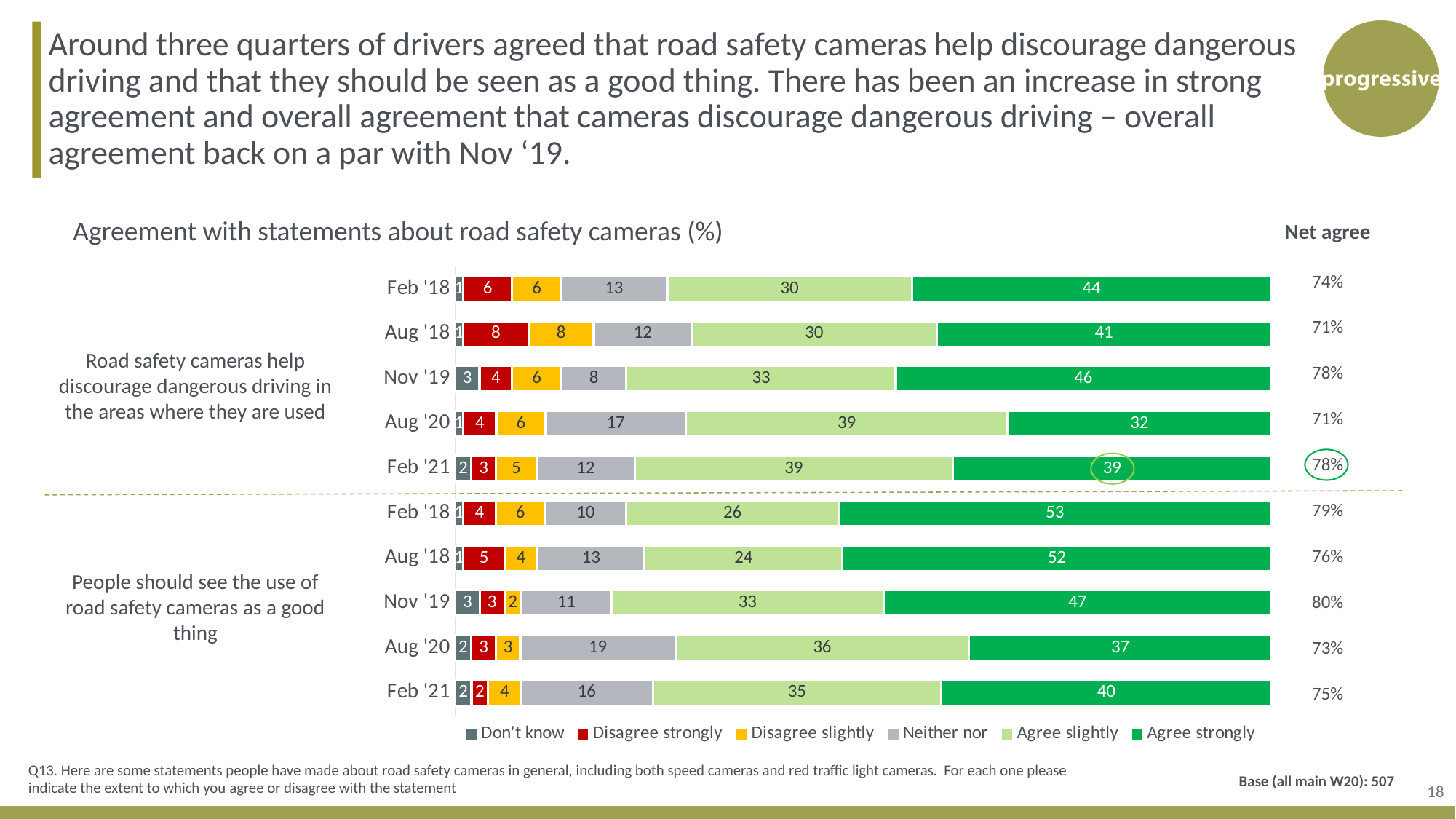
How many waves (bars) are shown for each statement in the chart? 5 For the statement 'People should see the use of road safety cameras as a good thing', is the 'Agree strongly' value larger in Nov '19 or Feb '21? Nov '19 What is the 'Neither nor' value for Aug '20 for the statement 'People should see the use of road safety cameras as a good thing'? 19 What is the Net agree figure for Nov '19 for the statement 'People should see the use of road safety cameras as a good thing'? 80% What is the combined 'Agree slightly' plus 'Agree strongly' total for Feb '21 for the statement 'Road safety cameras help discourage dangerous driving in the areas where they are used'? 78 Which wave has the lowest 'Agree strongly' value for the statement 'Road safety cameras help discourage dangerous driving in the areas where they are used'? Aug '20 What type of chart is shown on the slide? Stacked bar chart What is the title of the chart? Agreement with statements about road safety cameras (%) How many series does the chart legend list? 6 What is the difference between the 'Agree slightly' and 'Agree strongly' values for Aug '20 for the statement 'Road safety cameras help discourage dangerous driving in the areas where they are used'? 7 What is the 'Agree strongly' value for Feb '18 for the statement 'Road safety cameras help discourage dangerous driving in the areas where they are used'? 44 Which wave has the highest 'Agree strongly' value for the statement 'People should see the use of road safety cameras as a good thing'? Feb '18